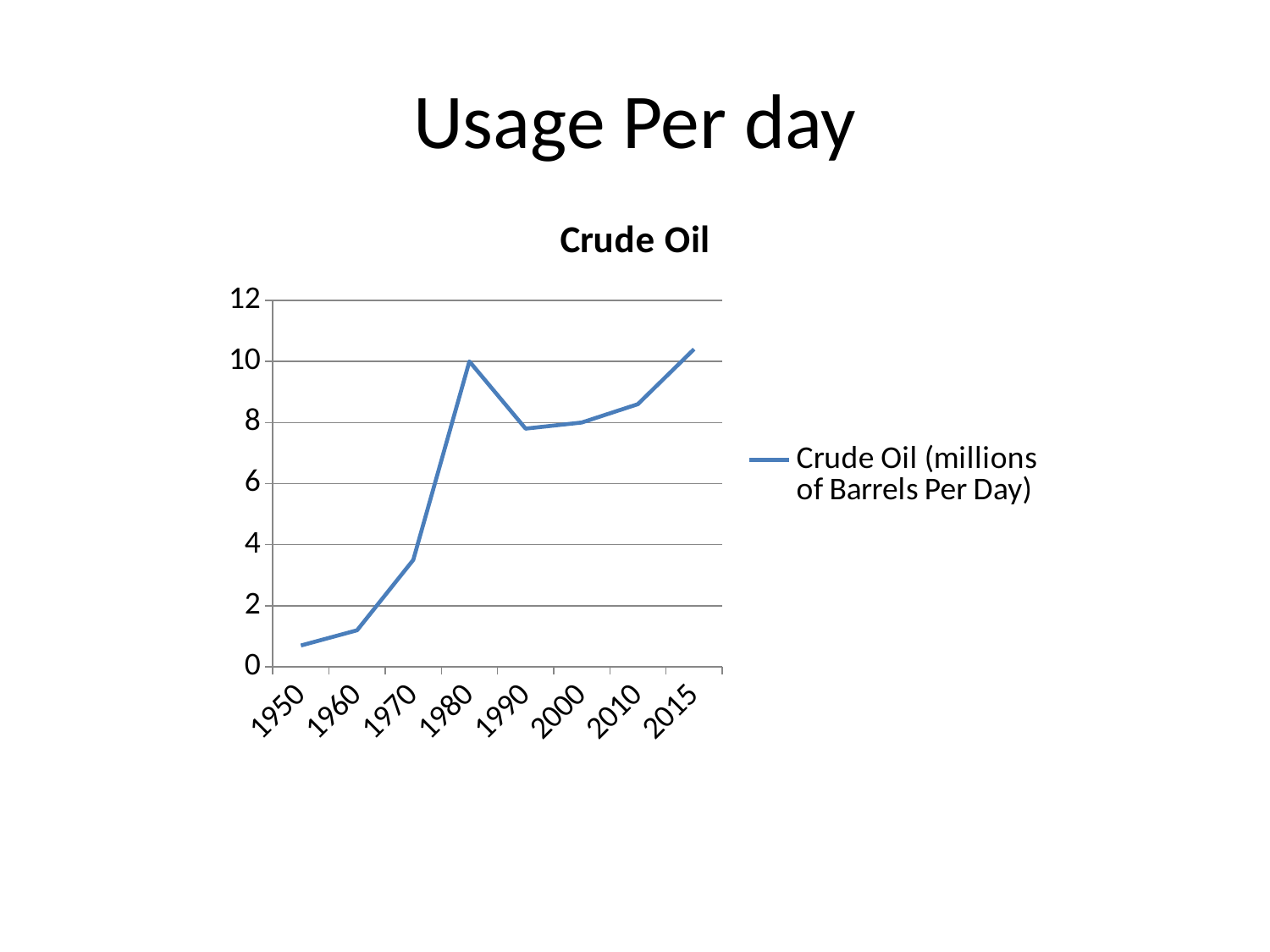
Is the value for 1950 greater or less than 2? less What is the title of the chart? Crude Oil Which is larger, the value for 1960 or the value for 1970? 1970 Is the value for 1970 greater or less than 4? less Is the value for 1980 greater or less than 8? greater Which is larger, the value for 1980 or the value for 1990? 1980 Which year has the lowest crude oil usage? 1950 How many years are plotted along the x axis? 8 How many series does the legend list? 1 Do the values rise or fall from 1950 to 1980? rise What kind of chart is shown on the slide? line chart